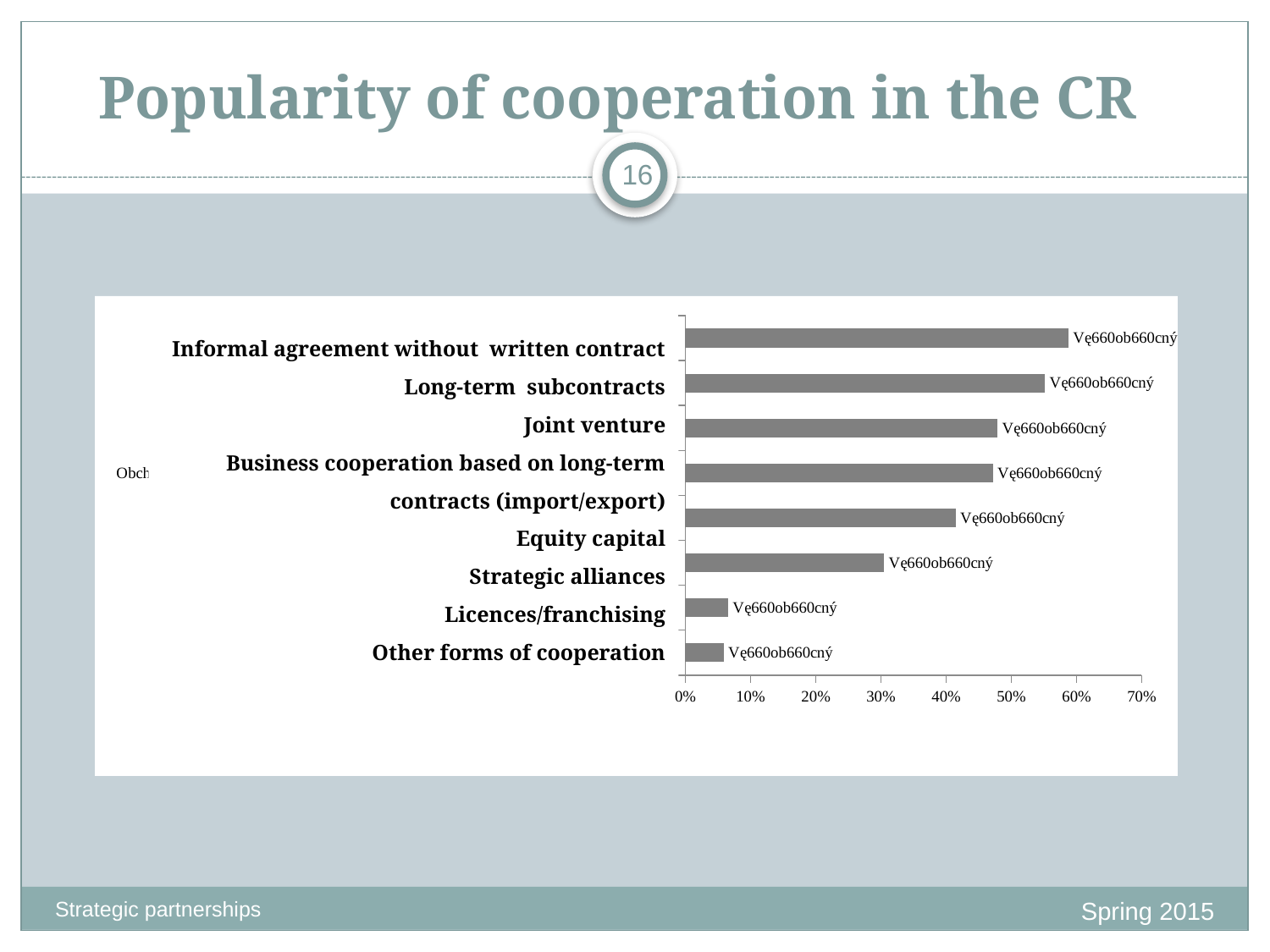
Is the value for Licences/franchising greater or less than 10%? less Is the value for Strategic alliances greater or less than 40%? less How many categories (bars) does the chart show? 8 What kind of chart is shown on the slide? bar chart What is the highest value shown on the horizontal axis of the chart? 70% Which category has the highest value in the chart? Informal agreement without written contract Is the value for Joint venture greater or less than 40%? greater Which is larger, the value for Long-term subcontracts or the value for Equity capital? Long-term subcontracts Which is larger, the value for Informal agreement without written contract or the value for Strategic alliances? Informal agreement without written contract